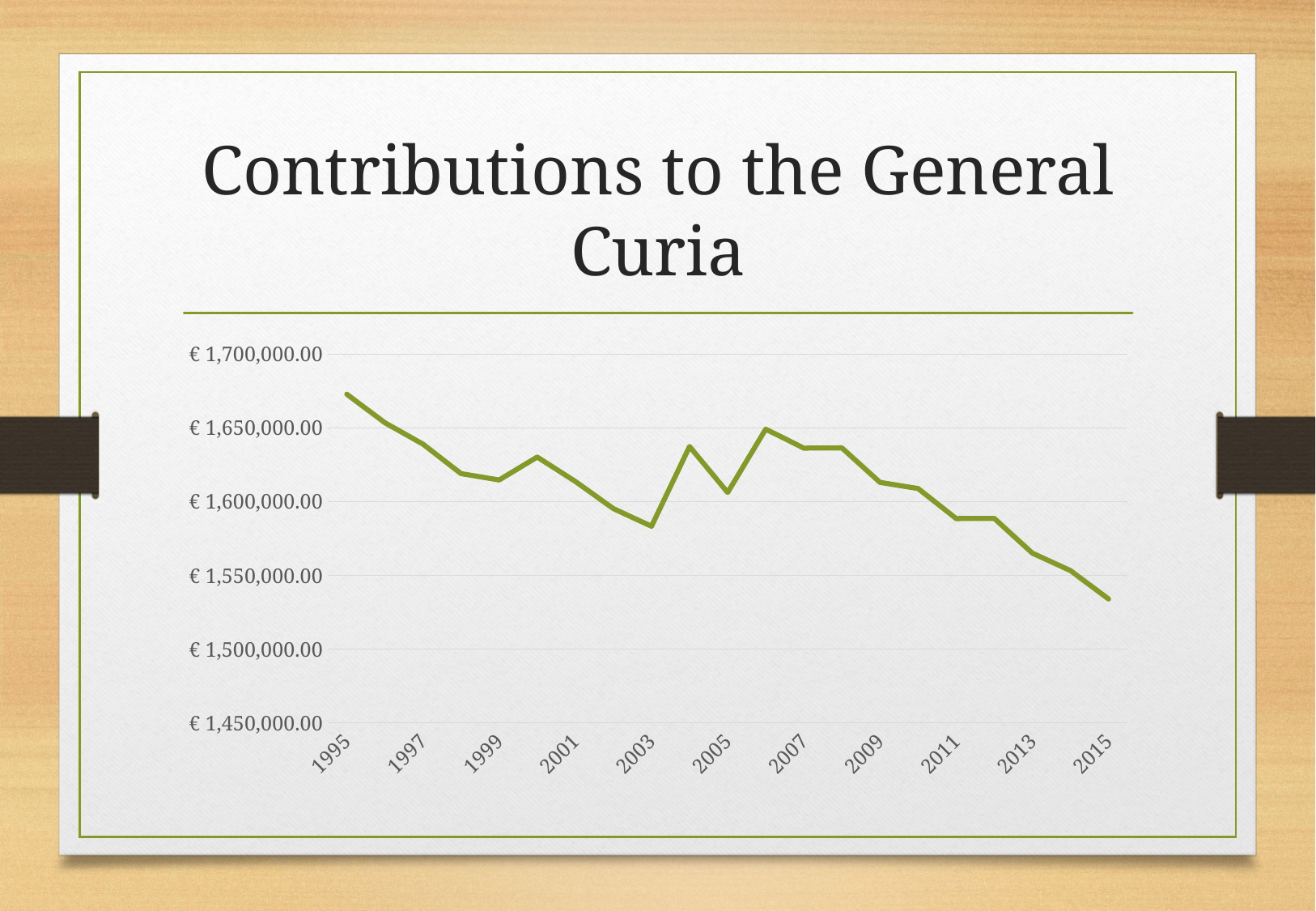
Is the value for 1995 greater or less than € 1,650,000.00? greater What kind of chart is shown on the slide? line chart Which year has the highest contribution? 1995 Is the value for 2015 greater or less than € 1,550,000.00? less Is the value for 2007 greater or less than € 1,600,000.00? greater Which year has the larger contribution, 1995 or 2015? 1995 How many year labels are shown on the x axis? 11 Overall, do the contributions rise or fall from 1995 to 2015? fall What is the title of the chart? Contributions to the General Curia Which year has the lowest contribution? 2015